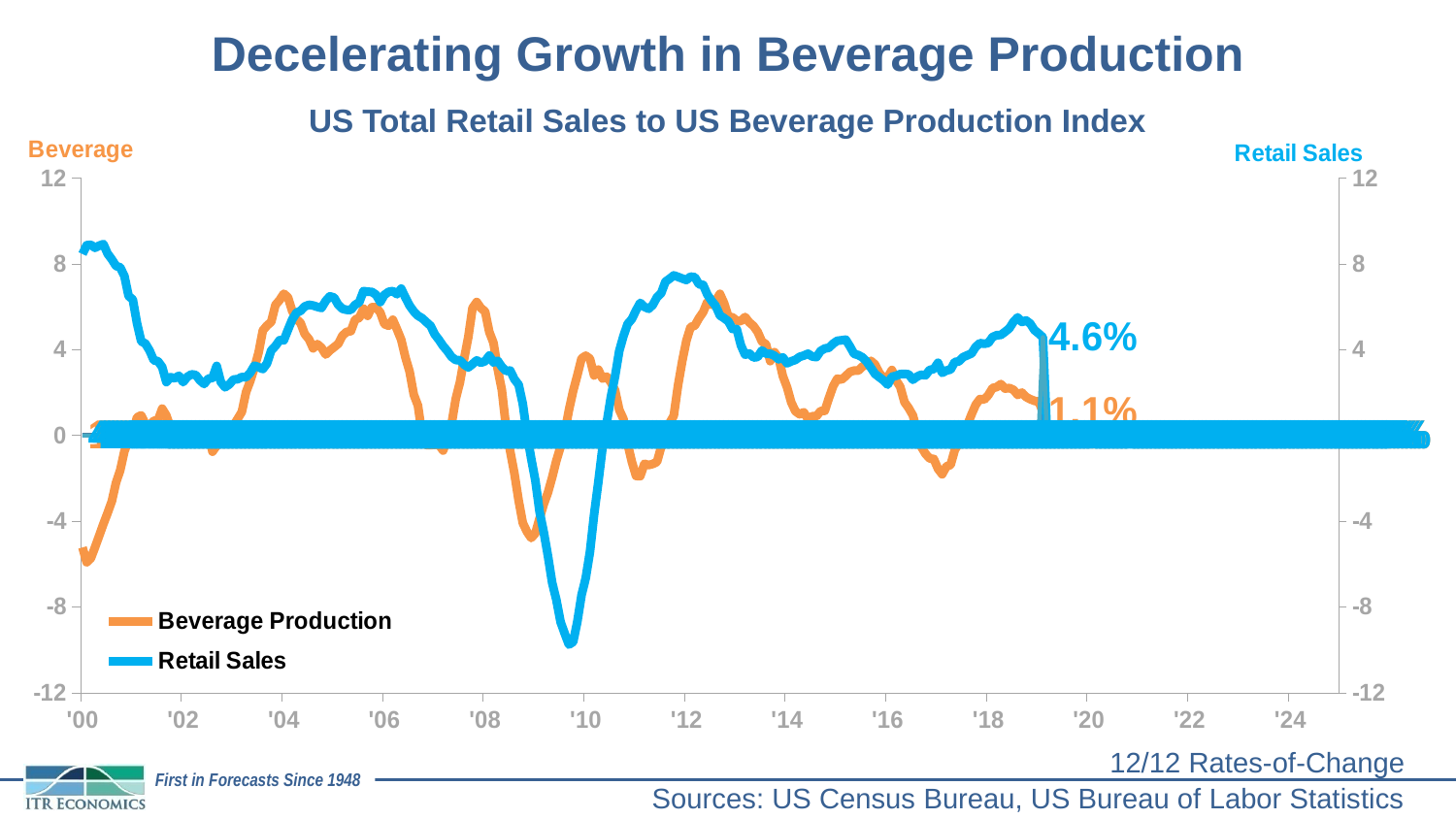
What is the latest labeled value for the Retail Sales series? 4.6% Is the lowest value of the Retail Sales line, around 2009-2010, greater or less than -8? less How many year labels are shown on the x axis? 13 What kind of chart is shown on the slide? Line chart Which colour represents the Beverage Production series? Orange What is the difference between the labeled Retail Sales value (4.6%) and the labeled Beverage Production value (1.1%)? 3.5 percentage points Is the Beverage Production value at the start of 2000 greater or less than -4? less Is the Retail Sales value at the start of 2000 greater or less than 8? greater At the latest labeled data point, which series is higher: Retail Sales or Beverage Production? Retail Sales What is the latest labeled value for the Beverage Production series? 1.1% Does the Retail Sales line rise or fall between '16 and '18? Rise How many series does the legend list? 2